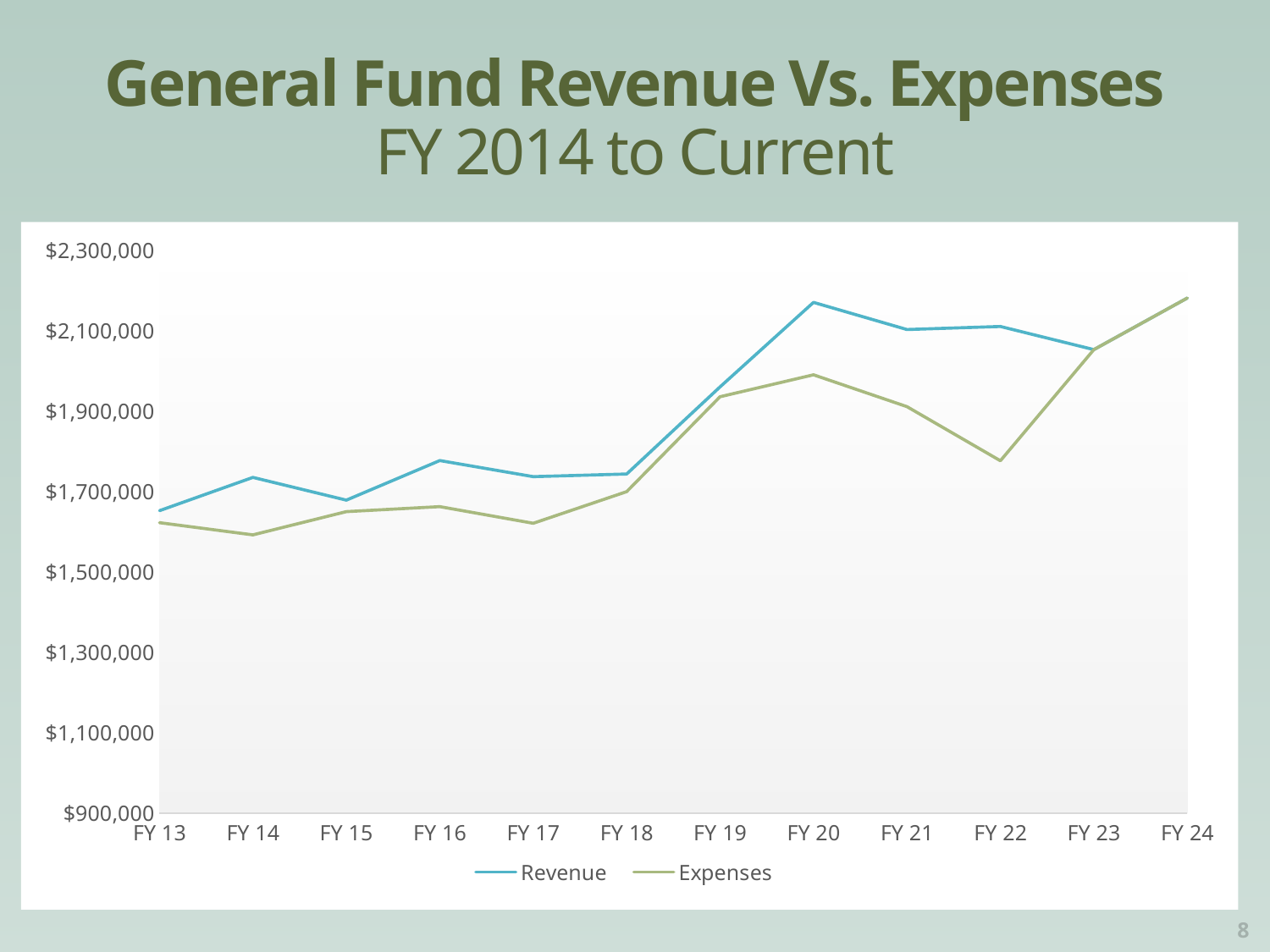
In which fiscal year are Expenses highest? FY 24 In FY 20, which is larger, Revenue or Expenses? Revenue How many fiscal years are shown along the x axis? 12 What kind of chart is shown on the slide? Line chart Do Expenses rise or fall from FY 20 to FY 22? Fall Is the Expenses value for FY 22 greater or less than $1,900,000? less Is the Expenses value for FY 24 greater or less than $2,100,000? greater How many series does the legend list? 2 Which series are listed in the legend? Revenue and Expenses In which fiscal year are Expenses lowest? FY 14 Is the Revenue value for FY 20 greater or less than $2,100,000? greater